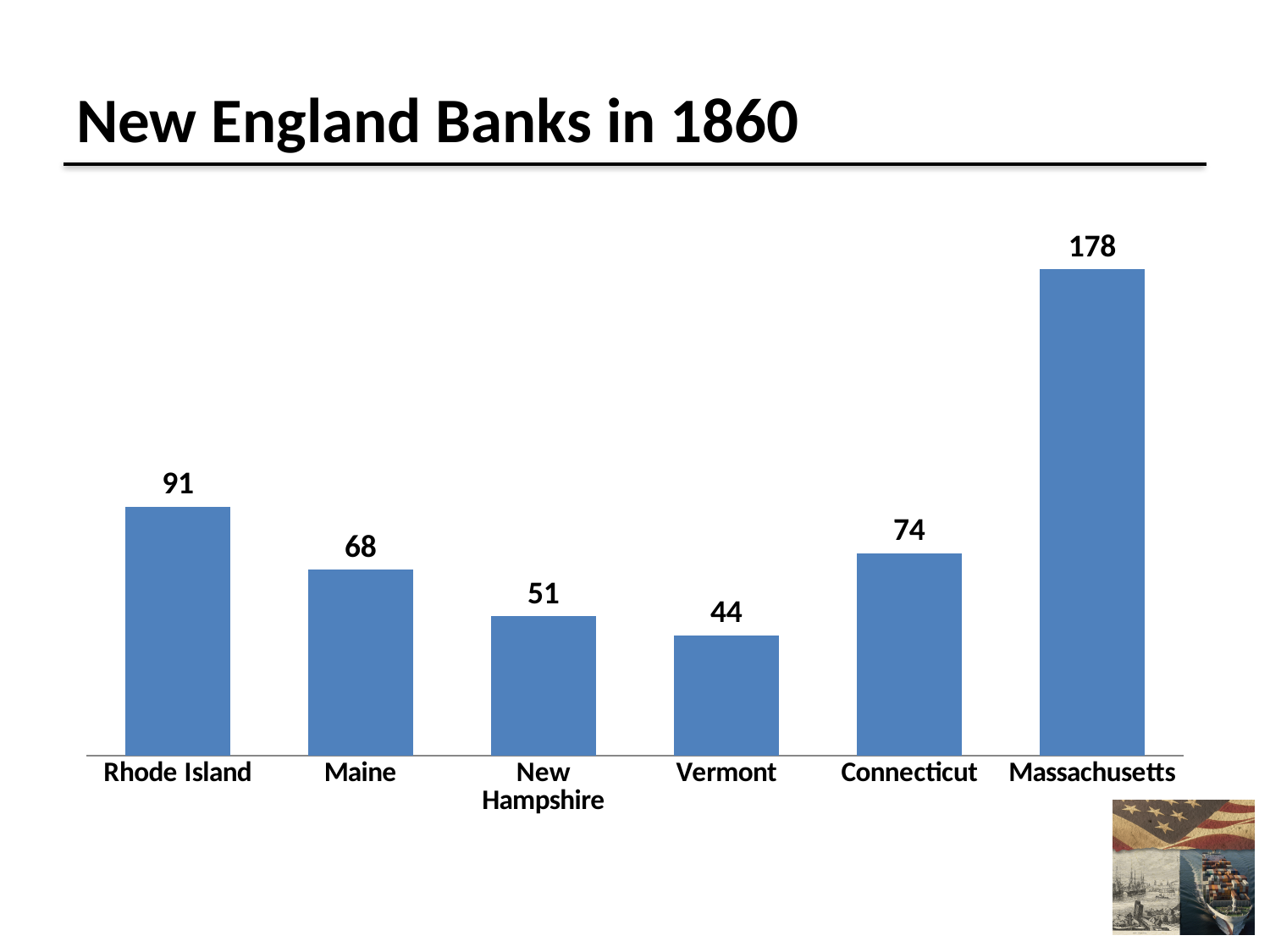
How many banks did Rhode Island have in 1860 according to the chart? 91 What is the difference between the values for Connecticut and Vermont? 30 What is the title of the slide? New England Banks in 1860 What is the value shown for New Hampshire? 51 What is the value shown for Connecticut? 74 Which has a larger value, Maine or Connecticut? Connecticut What kind of chart is shown on the slide? Bar chart What is the difference between the values for Massachusetts and Rhode Island? 87 How many states are shown in the chart? 6 Which state has the lowest number of banks in the chart? Vermont What is the value shown for Maine? 68 Which state has the highest number of banks in the chart? Massachusetts